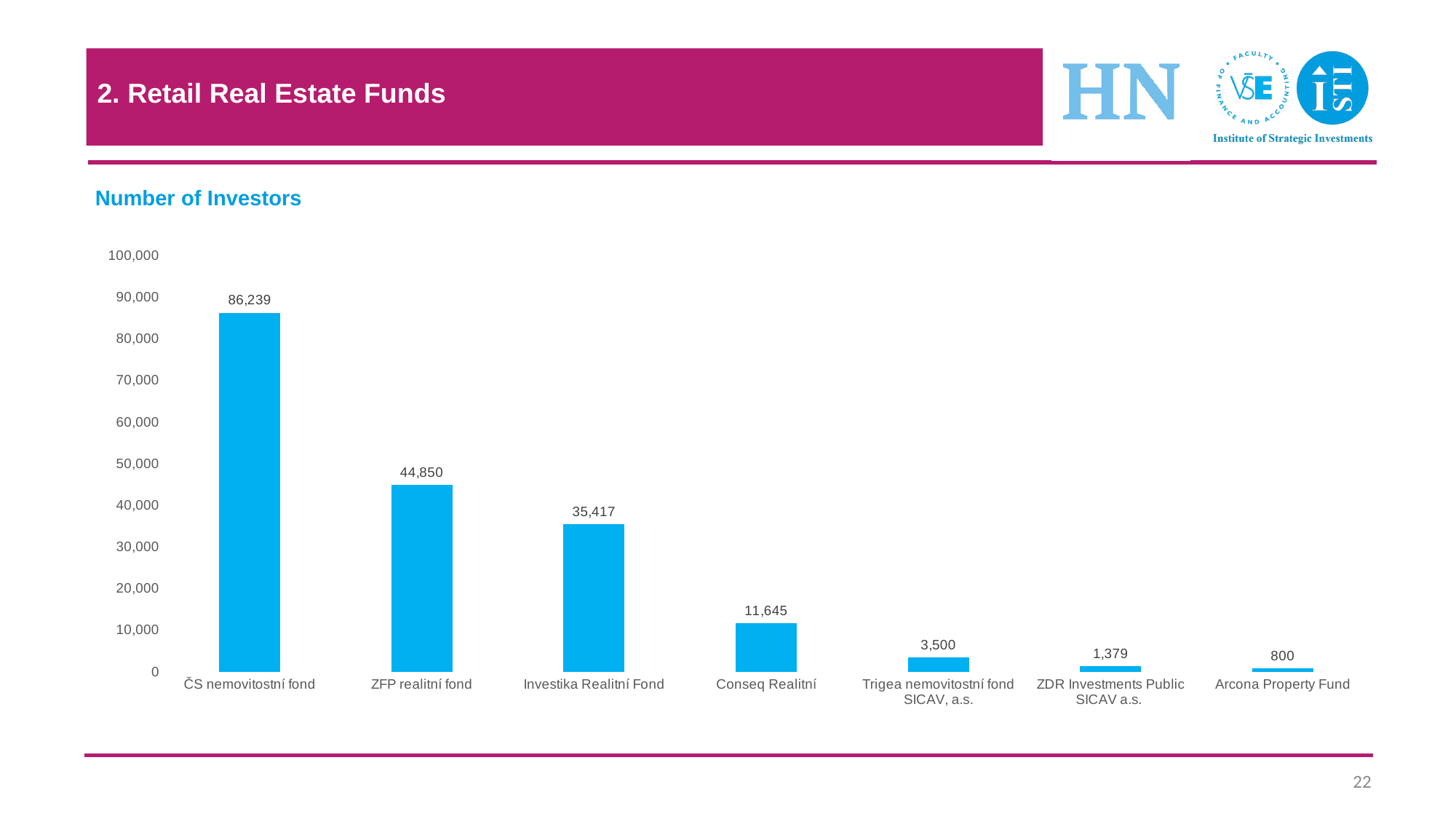
Is the number of investors for Conseq Realitní greater or less than 10,000? greater What is the number of investors for ZDR Investments Public SICAV a.s.? 1,379 What is the number of investors for ČS nemovitostní fond? 86,239 Which has more investors, ZFP realitní fond or Investika Realitní Fond? ZFP realitní fond What is the difference in number of investors between ČS nemovitostní fond and ZFP realitní fond? 41,389 Which fund has the highest number of investors? ČS nemovitostní fond How many funds are shown in the chart? 7 What is the number of investors for Investika Realitní Fond? 35,417 What is the difference in number of investors between Conseq Realitní and Trigea nemovitostní fond SICAV, a.s.? 8,145 What is the title of the chart? Number of Investors Which fund has the lowest number of investors? Arcona Property Fund What type of chart is shown on the slide? Bar chart